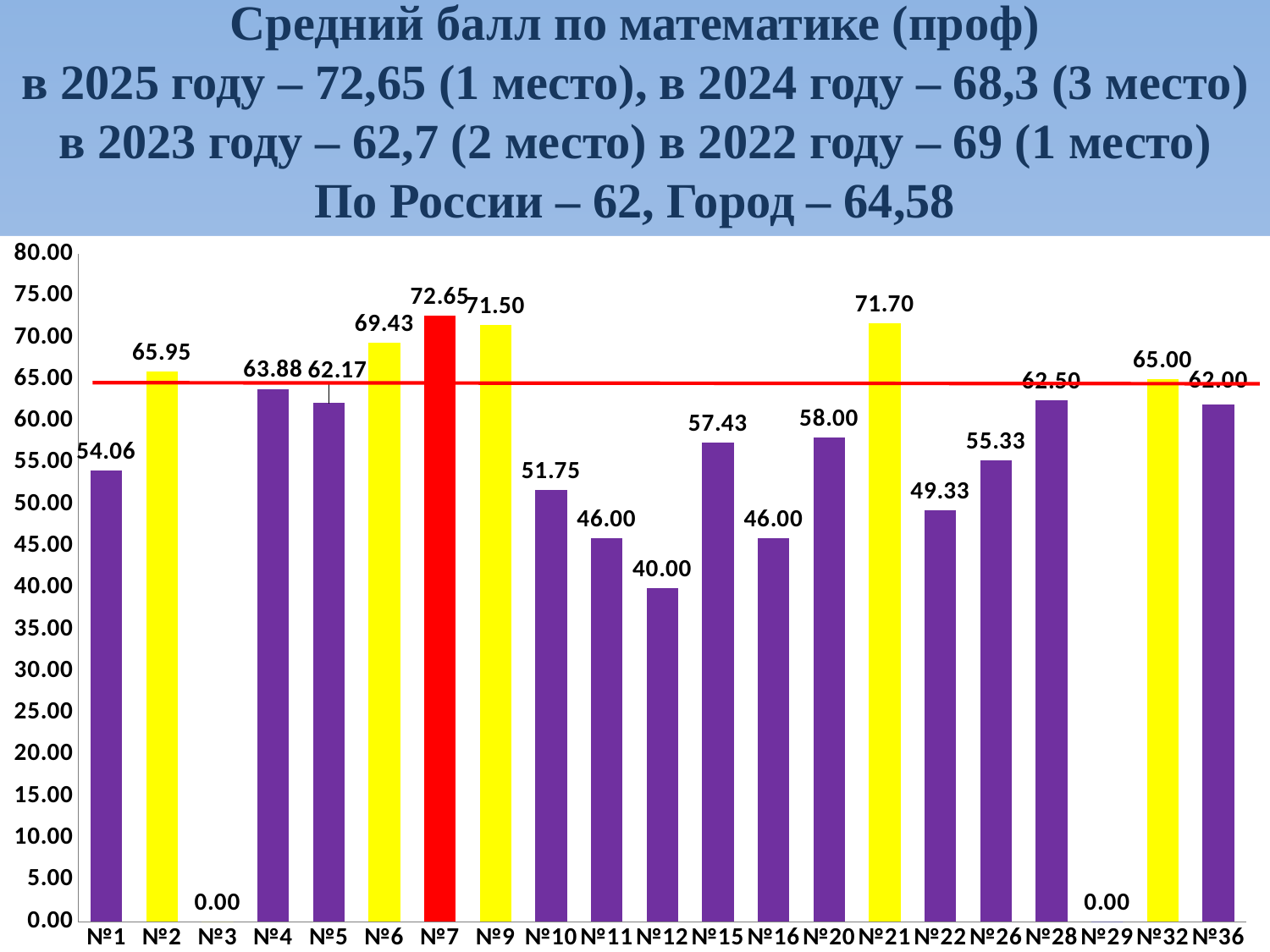
Which category has the lowest non-zero value? №12 Which category has the highest value? №7 What is the value shown for №12? 40.00 What kind of chart is this? Bar chart What is the value shown for №7? 72.65 Which category's bar is coloured red? №7 What is the value shown for №21? 71.70 What is the difference between the values for №7 and №9? 1.15 What is the difference between the values for №2 and №1? 11.89 Which is larger, the value for №15 or the value for №20? №20 How many categories are shown on the x axis? 21 What is the value shown for №26? 55.33